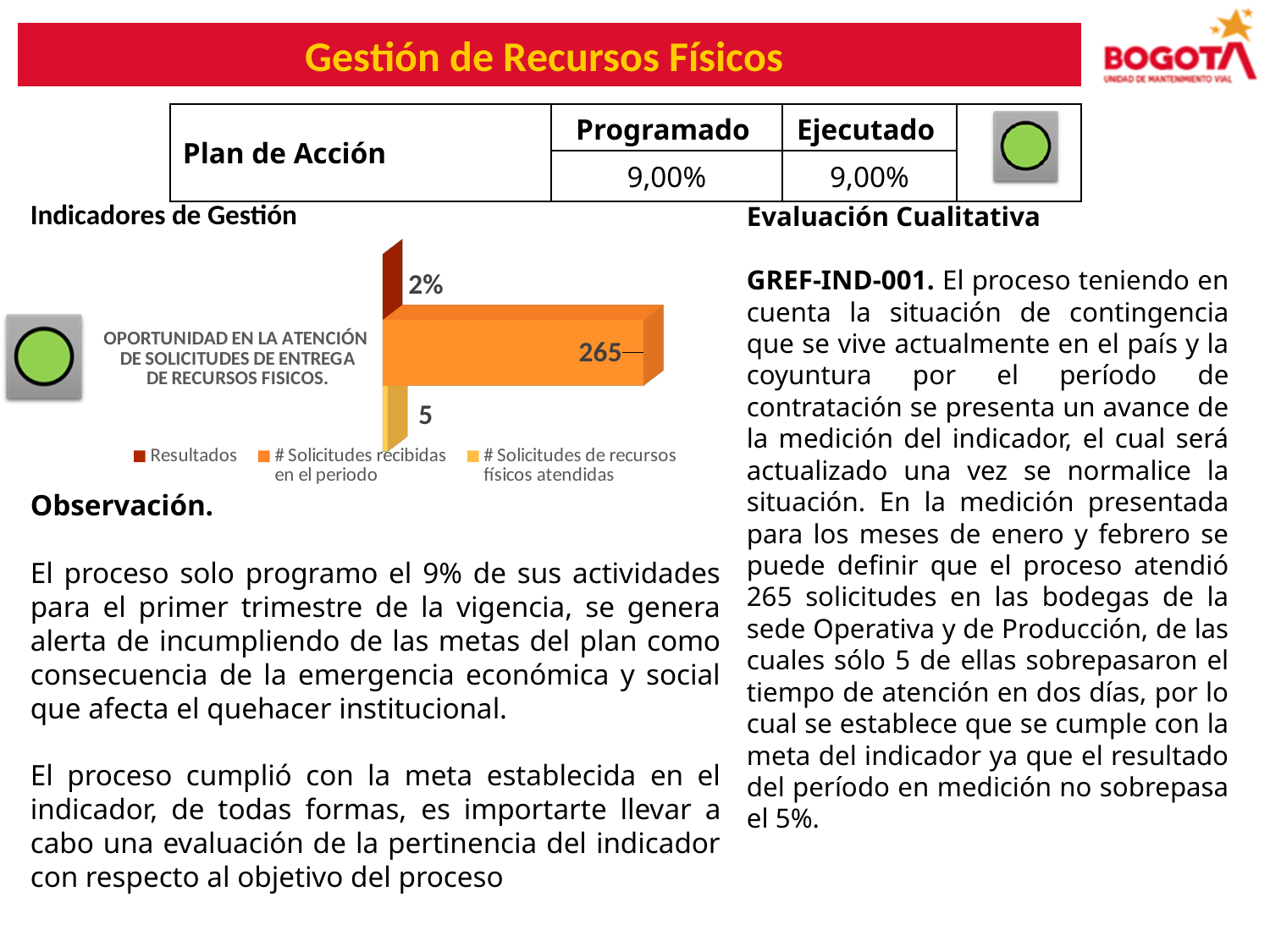
Which series in the chart is shown in dark red? Resultados What value is shown for the series "Resultados" in the chart? 2% What value is shown for the series "# Solicitudes de recursos físicos atendidas" in the chart? 5 What is the category label shown on the chart? OPORTUNIDAD EN LA ATENCIÓN DE SOLICITUDES DE ENTREGA DE RECURSOS FISICOS. How many categories are plotted on the chart's category axis? 1 What value is shown for the series "# Solicitudes recibidas en el periodo" in the chart? 265 Which is larger in the chart: "# Solicitudes recibidas en el periodo" or "# Solicitudes de recursos físicos atendidas"? # Solicitudes recibidas en el periodo Which series has the largest bar in the chart? # Solicitudes recibidas en el periodo How many series does the chart legend list? 3 What kind of chart is shown on the slide? Bar chart What is the difference between "# Solicitudes recibidas en el periodo" and "# Solicitudes de recursos físicos atendidas" in the chart? 260